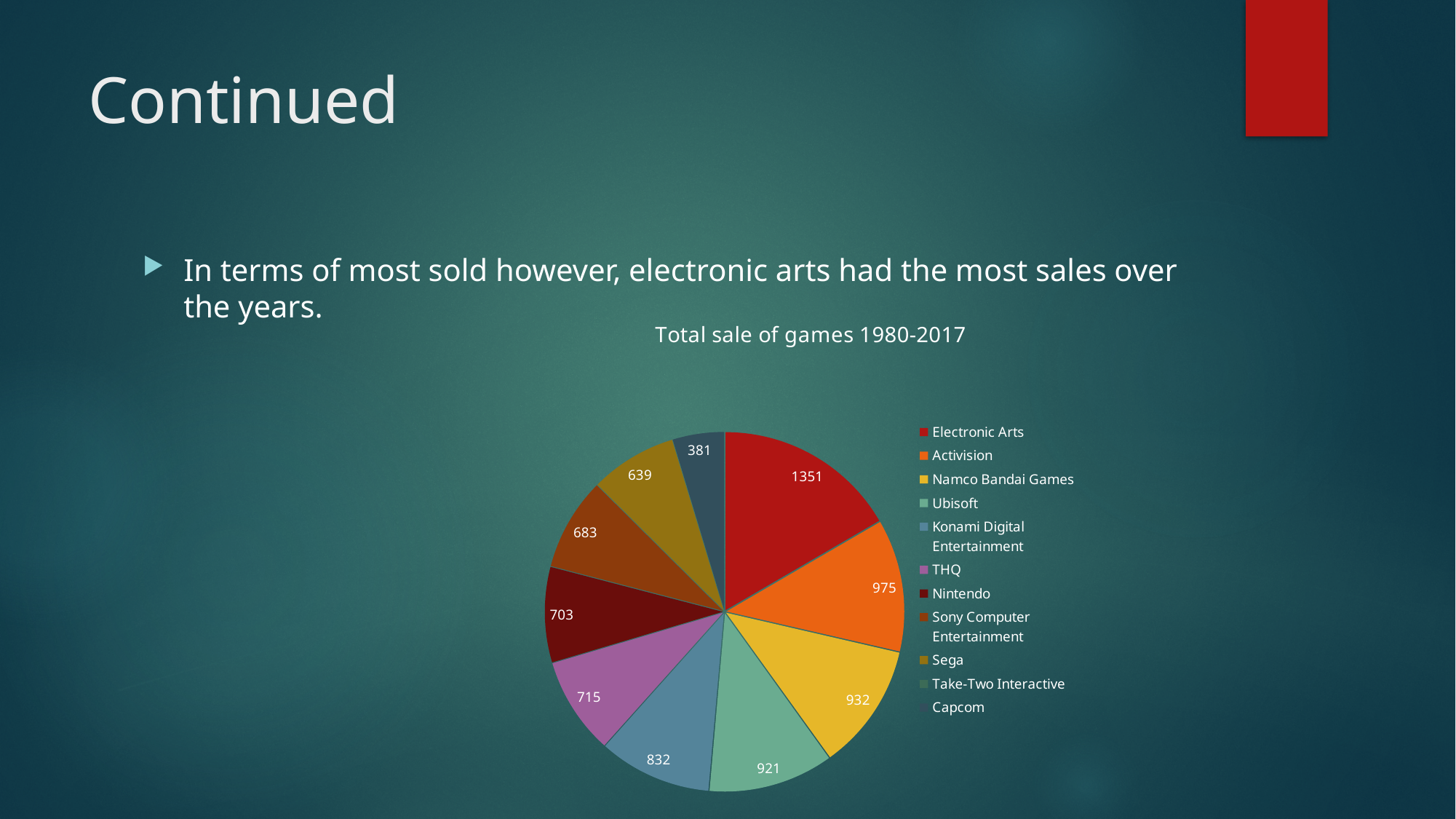
What is the value for Electronic Arts in the pie chart? 1351 What is the value for Activision in the pie chart? 975 What is the value for Konami Digital Entertainment in the pie chart? 832 What kind of chart is shown on the slide? Pie chart Which is larger, the value for THQ or the value for Sega? THQ What is the value for Sega in the pie chart? 639 What is the title of the chart on the slide? Total sale of games 1980-2017 What is the value for Ubisoft in the pie chart? 921 Which publisher has the largest slice in the pie chart? Electronic Arts How many entries does the legend of the pie chart list? 11 What is the difference between the values for Nintendo and Sony Computer Entertainment? 20 What is the difference between the values for Electronic Arts and Activision? 376